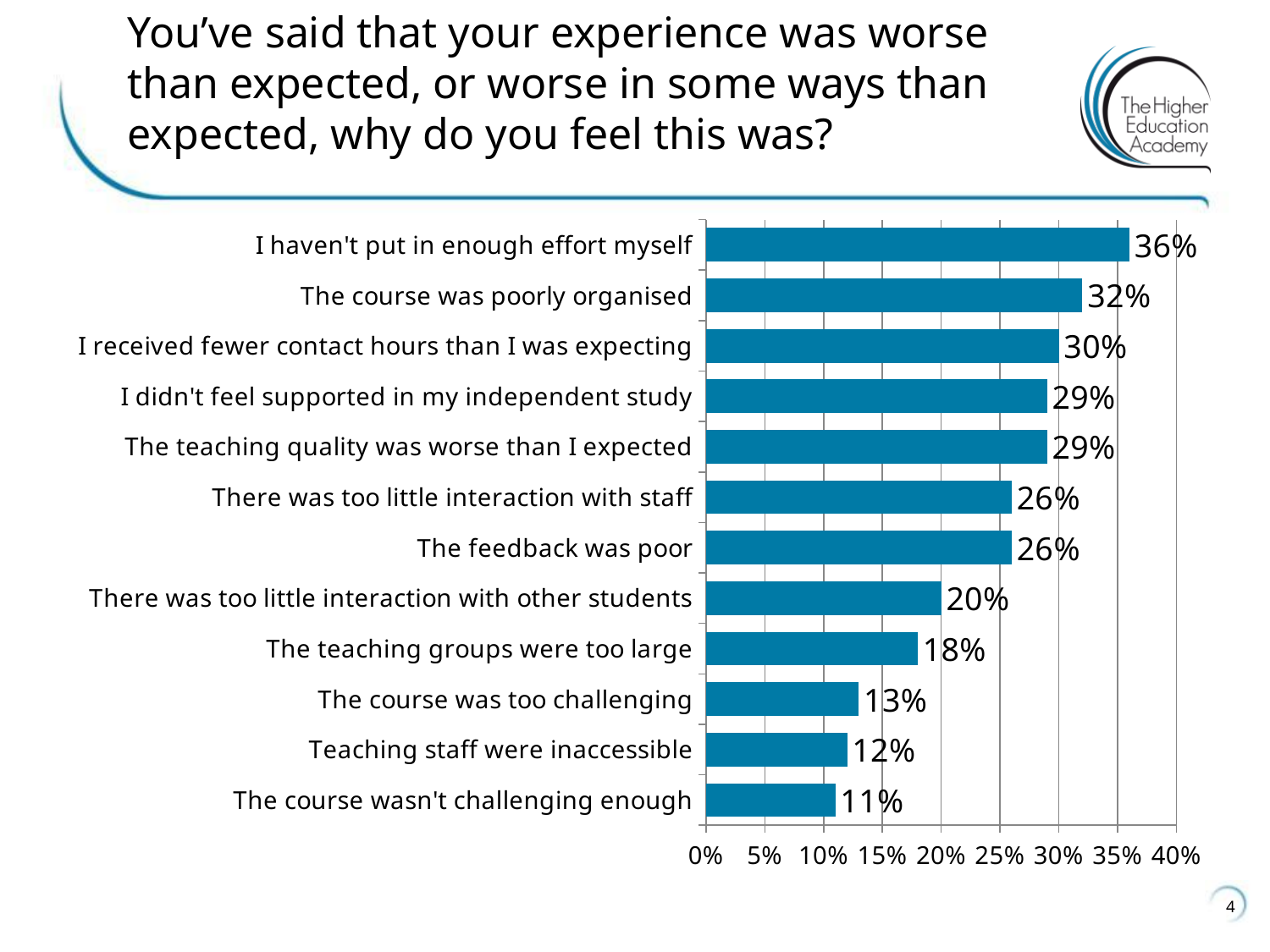
How many reasons are listed in the chart? 12 What is the value for "Teaching staff were inaccessible"? 12% What is the highest value shown on the percentage axis? 40% Is the value for "The feedback was poor" greater or less than 25%? greater What is the difference between "The course was poorly organised" and "The course was too challenging"? 19% What kind of chart is shown on the slide? Bar chart Which is larger: "There was too little interaction with other students" or "I received fewer contact hours than I was expecting"? I received fewer contact hours than I was expecting Which reason has the highest percentage? I haven't put in enough effort myself Which reason has the lowest percentage? The course wasn't challenging enough What is the difference between "I haven't put in enough effort myself" and "The course wasn't challenging enough"? 25% What percentage of respondents said "I haven't put in enough effort myself"? 36% What is the value for "The teaching groups were too large"? 18%